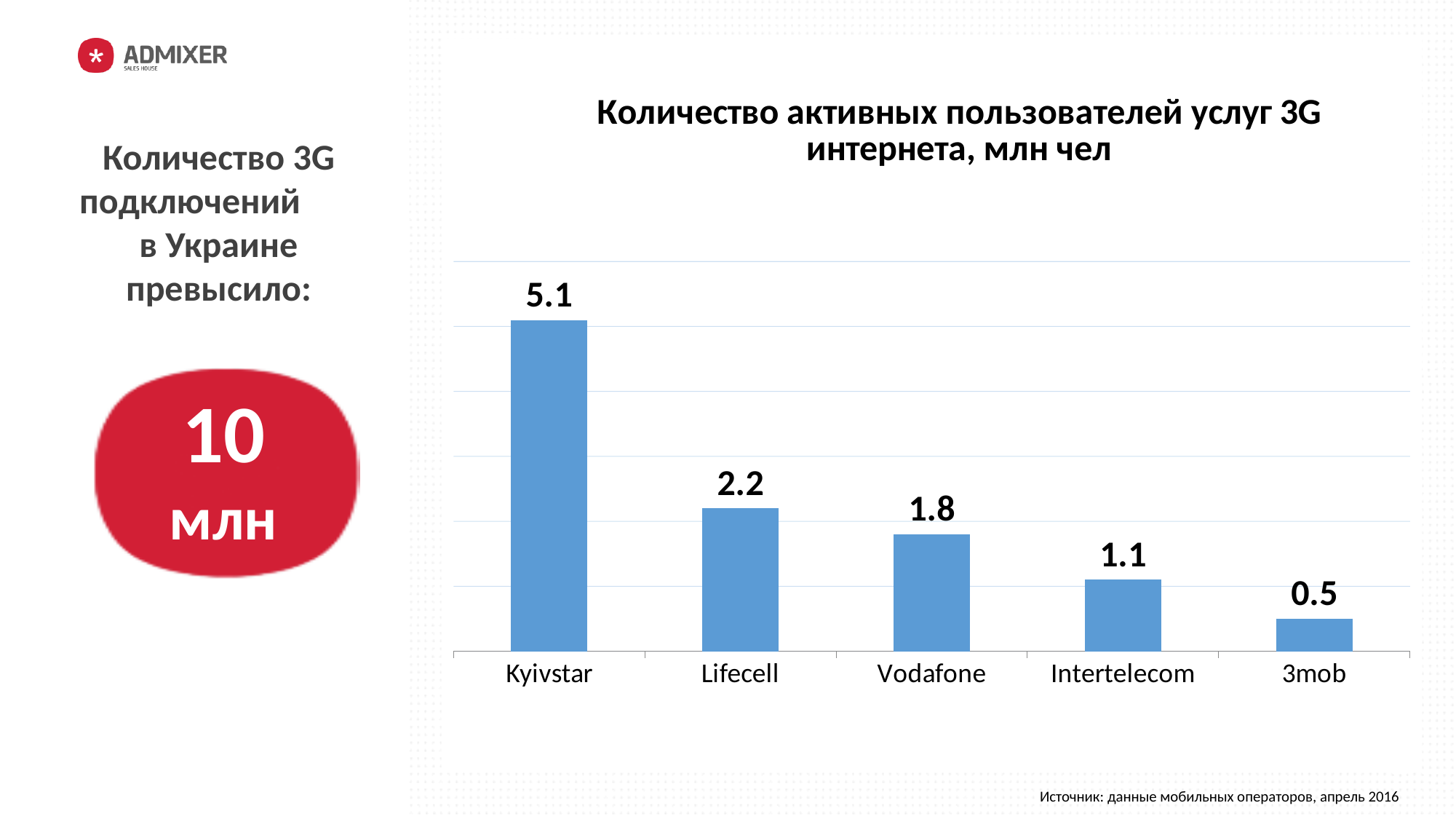
Which operator has the lowest number of active 3G internet users? 3mob What is the value for Intertelecom? 1.1 What is the value for Vodafone? 1.8 What is the value for 3mob? 0.5 What is the difference between the values for Kyivstar and Lifecell? 2.9 What is the title of the chart? Количество активных пользователей услуг 3G интернета, млн чел What is the value for Lifecell? 2.2 Which is larger, the value for Vodafone or the value for Intertelecom? Vodafone How many operators are shown in the chart? 5 What kind of chart is shown on the slide? Bar chart What is the value for Kyivstar? 5.1 Which operator has the highest number of active 3G internet users? Kyivstar